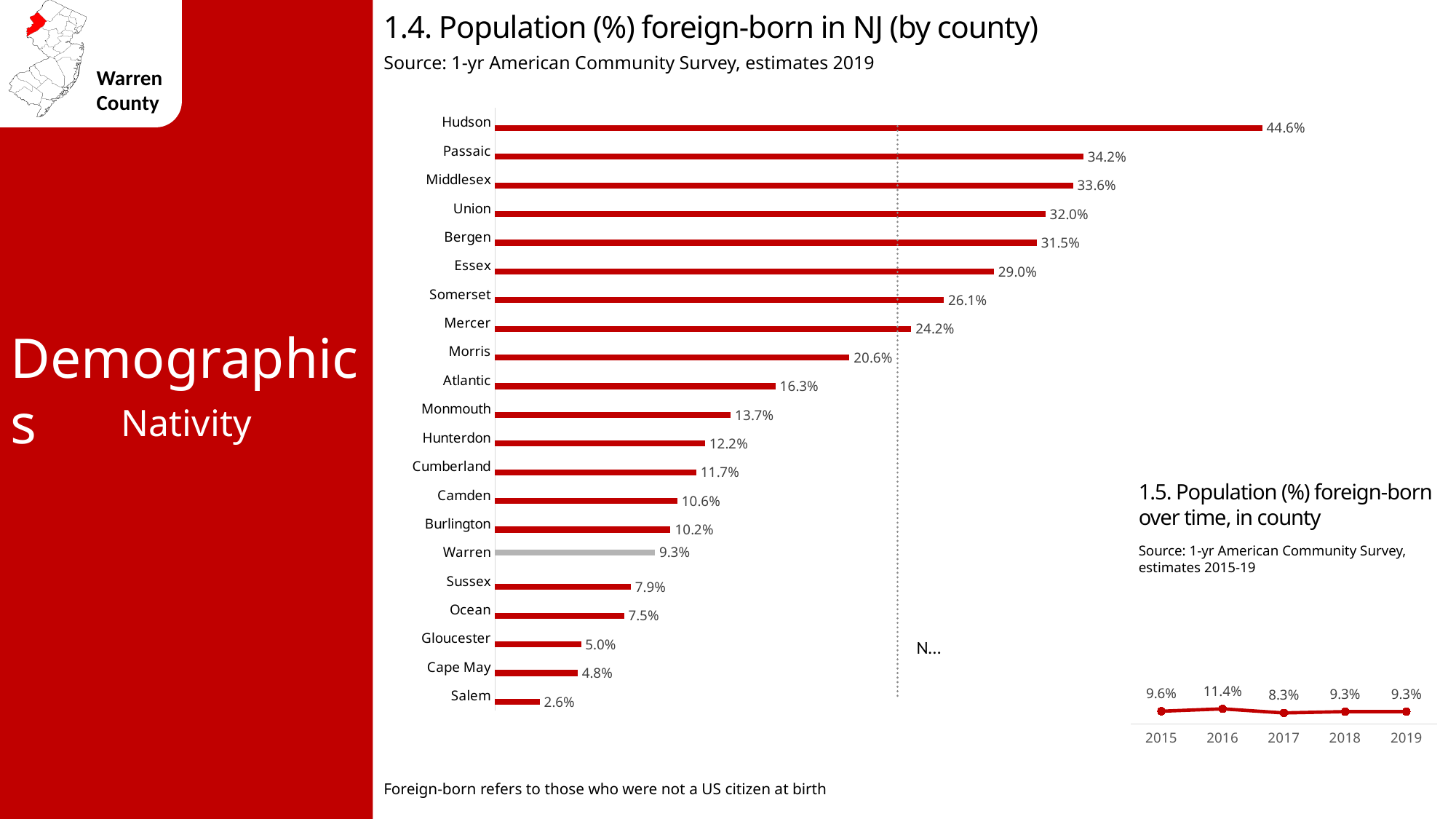
In the chart '1.5. Population (%) foreign-born over time, in county', how many years are plotted? 5 In the chart '1.4. Population (%) foreign-born in NJ (by county)', what is the value for Warren? 9.3% In the chart '1.4. Population (%) foreign-born in NJ (by county)', which county has the highest value? Hudson In the chart '1.5. Population (%) foreign-born over time, in county', what is the value for 2016? 11.4% In the chart '1.4. Population (%) foreign-born in NJ (by county)', what is the value for Mercer? 24.2% In the chart '1.4. Population (%) foreign-born in NJ (by county)', which county's bar is shown in grey instead of red? Warren What kind of chart is '1.4. Population (%) foreign-born in NJ (by county)'? Bar chart In the chart '1.4. Population (%) foreign-born in NJ (by county)', how many counties are shown? 21 In the chart '1.4. Population (%) foreign-born in NJ (by county)', which county has the lowest value? Salem In the chart '1.5. Population (%) foreign-born over time, in county', which year has the lowest value? 2017 In the chart '1.4. Population (%) foreign-born in NJ (by county)', which is larger, Camden or Burlington? Camden In the chart '1.4. Population (%) foreign-born in NJ (by county)', what is the difference between Hudson and Passaic? 10.4%